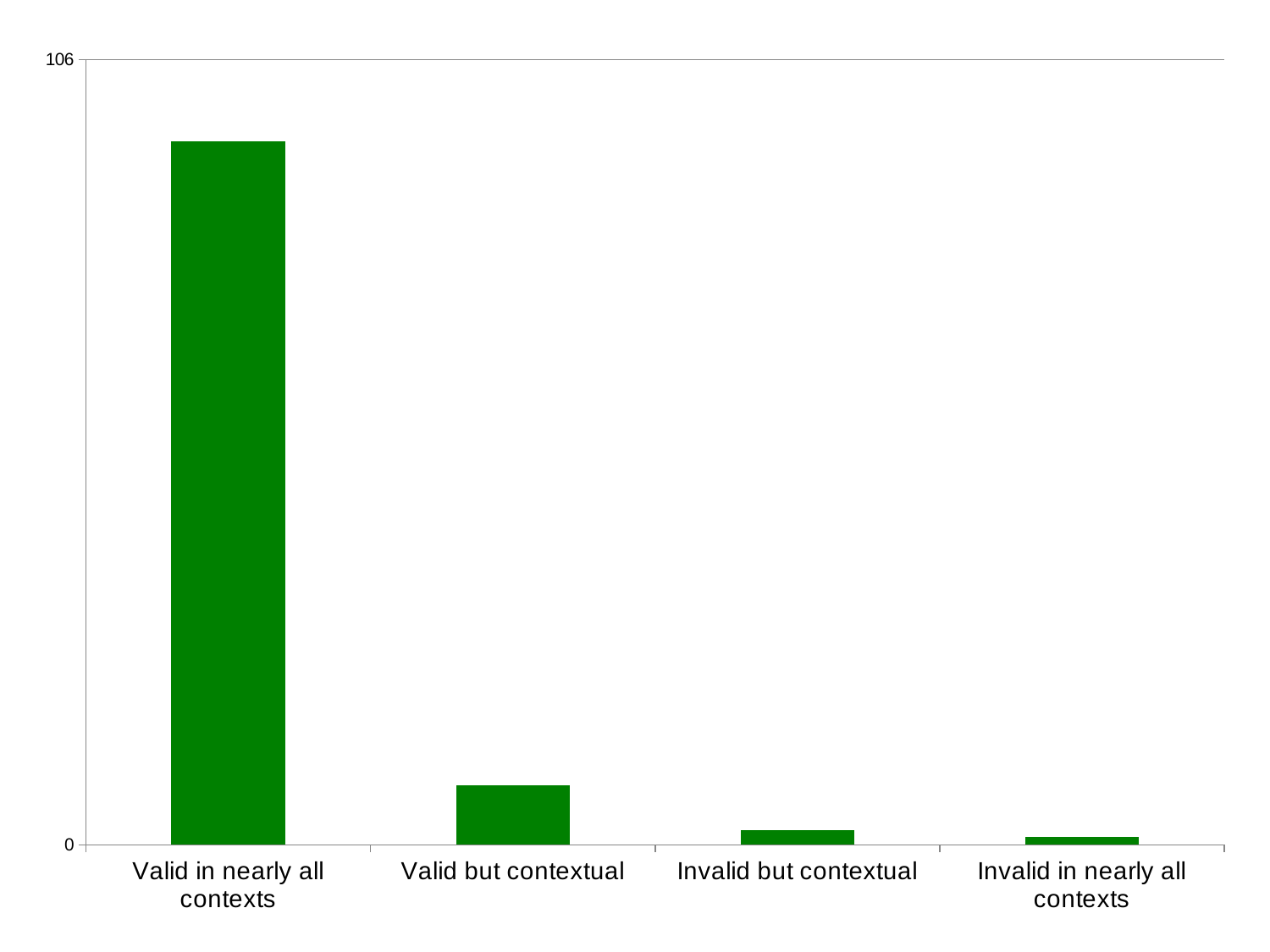
What colour are the bars in the chart? Green Which category has the highest bar? Valid in nearly all contexts Which category has the lowest bar? Invalid in nearly all contexts Do the bar values rise or fall from left to right along the x axis? Fall Which is larger, the value for Valid in nearly all contexts or the value for Valid but contextual? Valid in nearly all contexts What is the highest value labelled on the y axis? 106 Which is larger, the value for Valid but contextual or the value for Invalid but contextual? Valid but contextual What kind of chart is shown on the slide? Bar chart How many categories are shown on the x axis? 4 Which is larger, the value for Invalid but contextual or the value for Invalid in nearly all contexts? Invalid but contextual